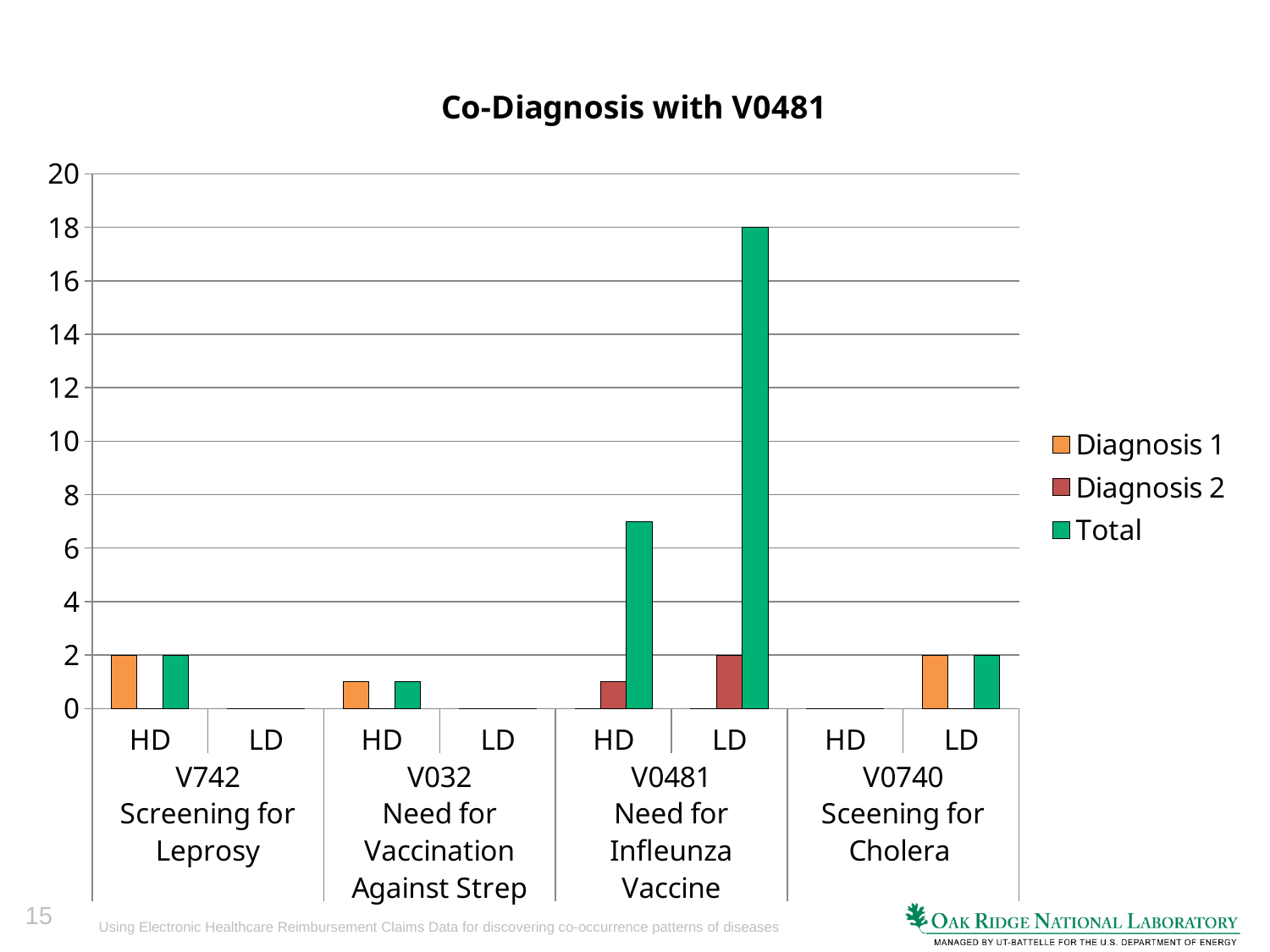
What is the title of the chart? Co-Diagnosis with V0481 Is the Total value for HD under V0481 greater or less than 6? greater How many diagnosis code groups are shown along the x axis? 4 What is the Diagnosis 2 value for LD under V0481 Need for Influenza Vaccine? 2 Which is larger, the Total for HD under V0481 or the Total for LD under V0481? LD under V0481 What is the difference between the Total and Diagnosis 2 values for LD under V0481? 16 What kind of chart is shown on the slide? Bar chart What is the Total value for LD under V0740 Screening for Cholera? 2 What is the Diagnosis 1 value for HD under V742 Screening for Leprosy? 2 Which category has the highest Total value? LD under V0481 What is the Total value for LD under V0481 Need for Influenza Vaccine? 18 How many series does the legend list? 3